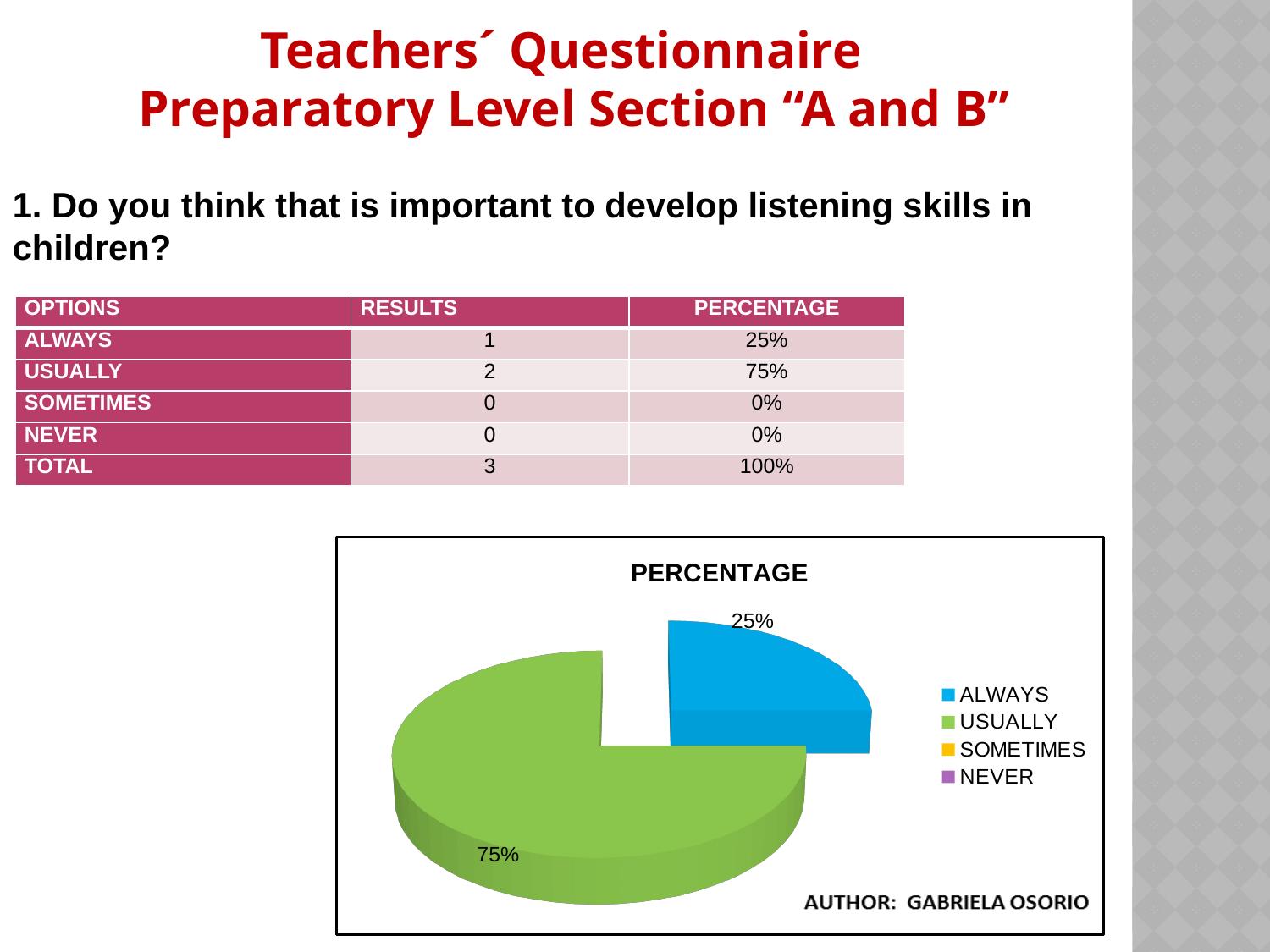
Which category has the largest slice in the pie chart? USUALLY What colour is the USUALLY slice in the pie chart? green What kind of chart is shown on the slide? pie chart What is the chart's title? PERCENTAGE How many entries does the legend of the pie chart list? 4 What percentage does the USUALLY slice show in the pie chart? 75% What share of the pie does the ALWAYS slice represent? 25% What percentage does the ALWAYS slice show in the pie chart? 25% What is the difference between the USUALLY and ALWAYS percentages shown in the pie chart? 50% Which is larger in the pie chart, the ALWAYS slice or the USUALLY slice? USUALLY